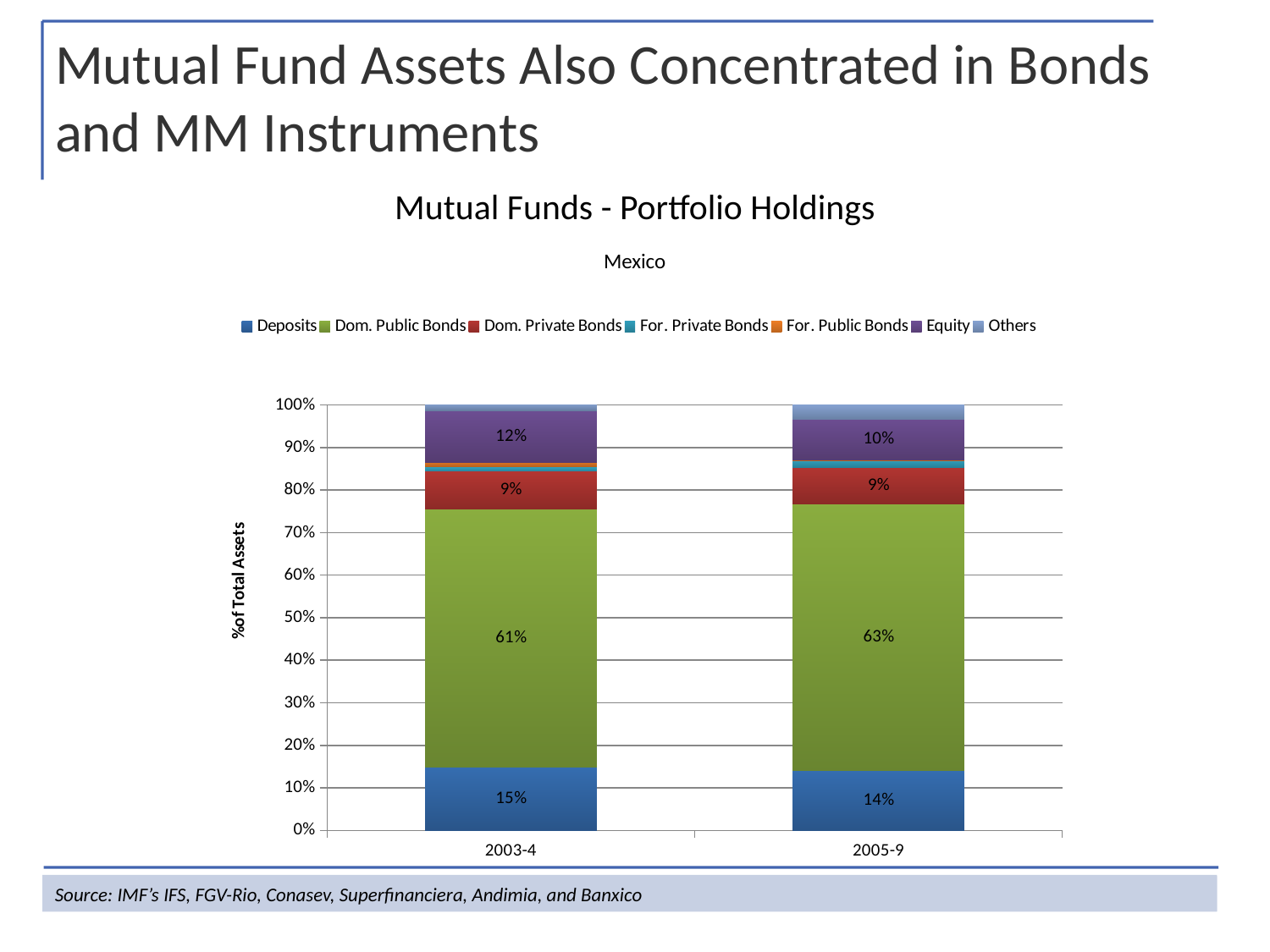
How many series does the legend list? 7 What kind of chart is shown on the slide? Stacked bar chart Did the Dom. Public Bonds share rise or fall from 2003-4 to 2005-9? Rise What is the Equity share of total assets in 2003-4? 12% Which period has the larger Equity share, 2003-4 or 2005-9? 2003-4 What percentage of total assets did Deposits represent in 2005-9? 14% Is the Others share in 2005-9 greater or less than 10%? less Which series makes up the largest share of total assets in 2005-9? Dom. Public Bonds By how many percentage points did the Dom. Public Bonds share change from 2003-4 to 2005-9? 2 percentage points What percentage of total assets did Dom. Public Bonds represent in 2003-4? 61% How many periods are shown on the x axis? 2 What is the Dom. Private Bonds share of total assets in 2005-9? 9%